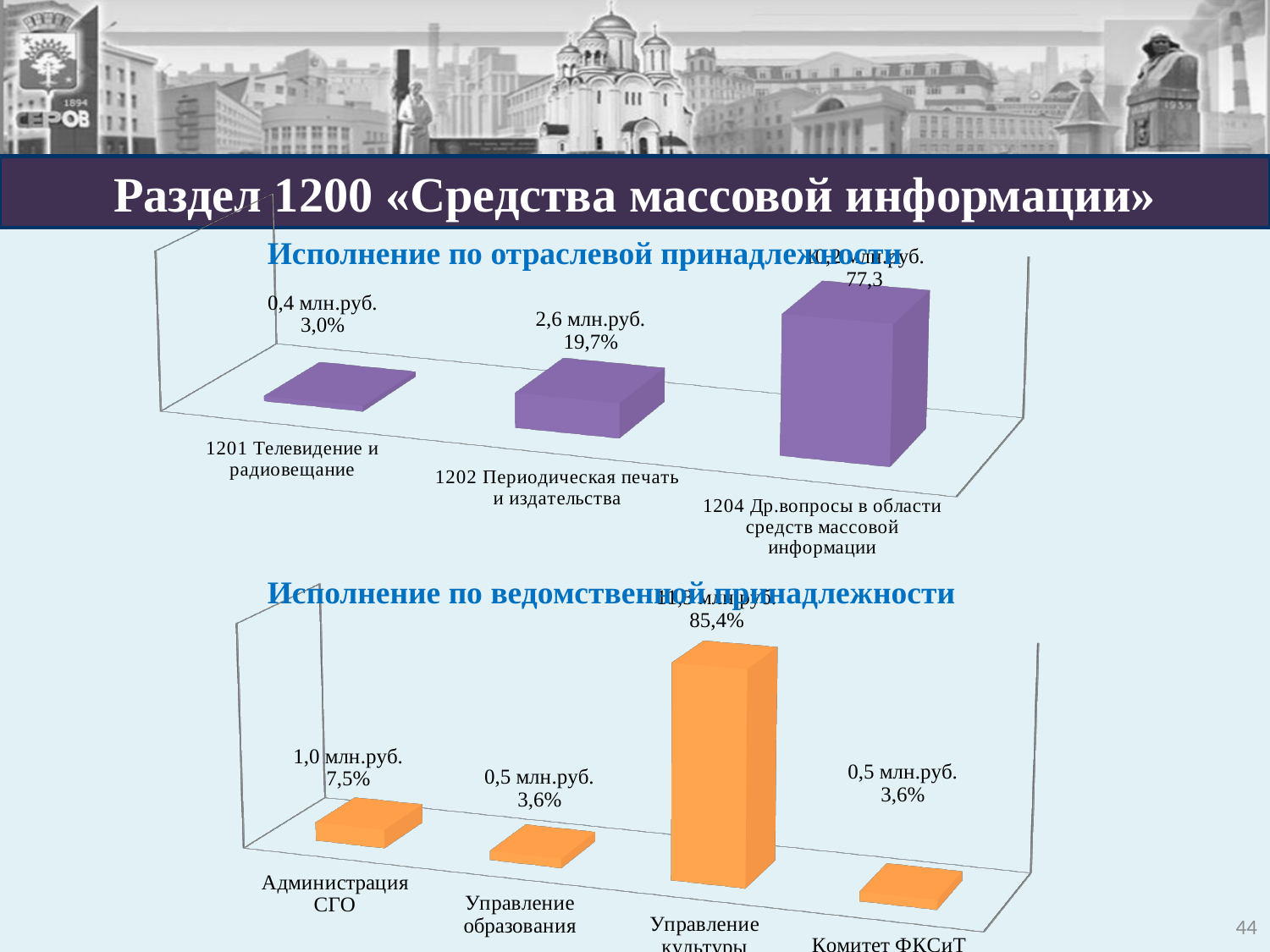
In the bottom chart «Исполнение по ведомственной принадлежности», how many categories are plotted? 4 In the bottom chart «Исполнение по ведомственной принадлежности», what percentage is shown for Управление культуры? 85,4% In the top chart «Исполнение по отраслевой принадлежности», what is the value for 1201 Телевидение и радиовещание? 0,4 млн.руб. In the bottom chart «Исполнение по ведомственной принадлежности», which is larger: the value for Администрация СГО or for Комитет ФКСиТ? Администрация СГО In the top chart «Исполнение по отраслевой принадлежности», how many categories are plotted? 3 What kind of chart is the bottom chart «Исполнение по ведомственной принадлежности»? bar chart In the top chart «Исполнение по отраслевой принадлежности», which category has the lowest value? 1201 Телевидение и радиовещание In the bottom chart «Исполнение по ведомственной принадлежности», what is the value for Администрация СГО? 1,0 млн.руб. In the top chart «Исполнение по отраслевой принадлежности», what is the difference in млн.руб. between 1202 Периодическая печать и издательства and 1201 Телевидение и радиовещание? 2,2 млн.руб. In the bottom chart «Исполнение по ведомственной принадлежности», which category has the highest value? Управление культуры In the top chart «Исполнение по отраслевой принадлежности», which category has the highest value? 1204 Др.вопросы в области средств массовой информации In the top chart «Исполнение по отраслевой принадлежности», what percentage is shown for 1202 Периодическая печать и издательства? 19,7%